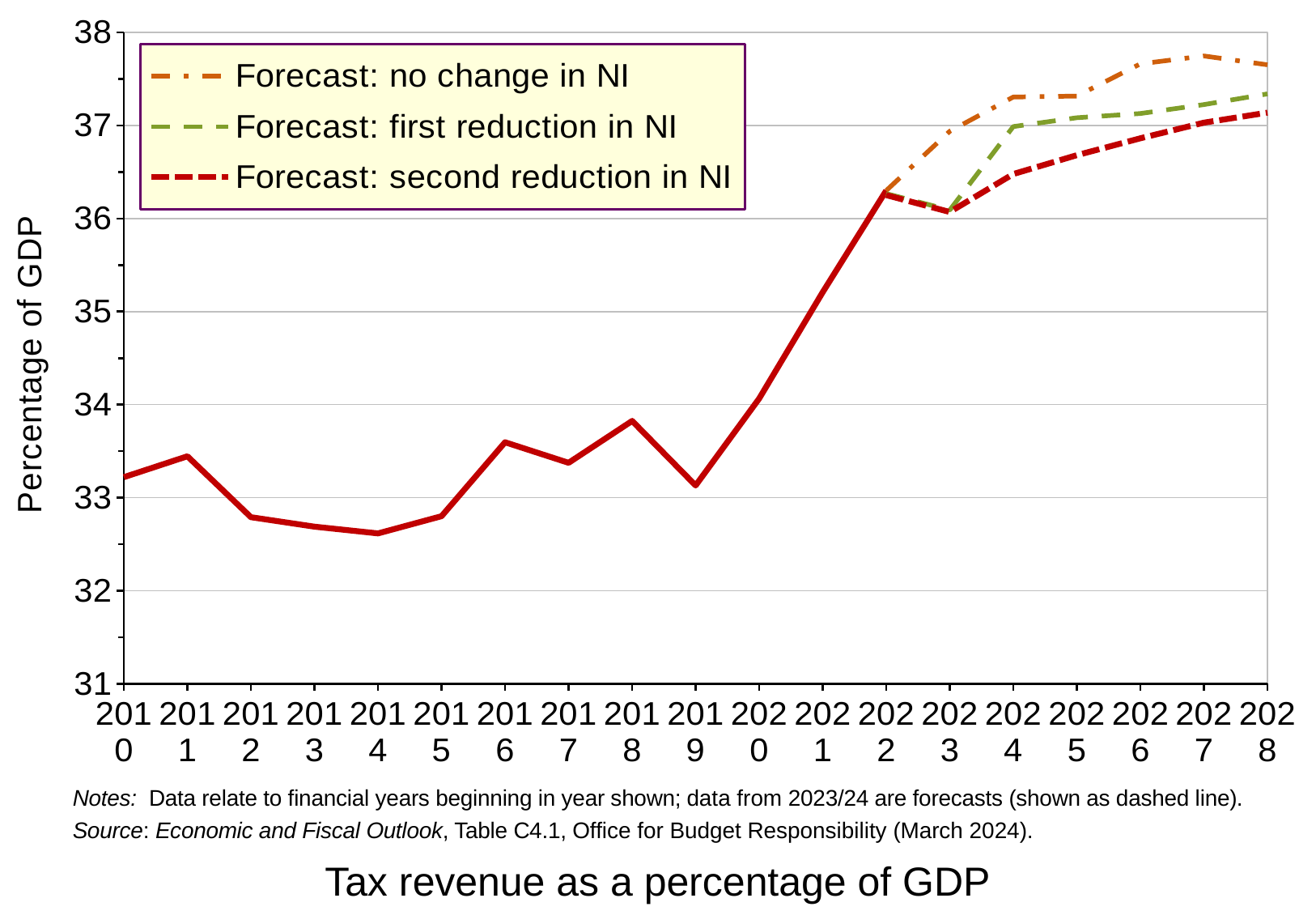
Do the values rise or fall between 2019 and 2022? rise Which is larger, the value for 2018 or the value for 2019? 2018 What is the label on the y axis? Percentage of GDP Is the value for 2022 greater or less than 36? greater Which year has the lowest tax revenue as a percentage of GDP? 2014 What kind of chart is shown on the slide? line chart What is the title of the chart? Tax revenue as a percentage of GDP Is the value for 2014 greater or less than 33? less Is the value for 2021 greater or less than 35? greater How many series does the legend list? 3 In 2028, which forecast series has the highest value? Forecast: no change in NI